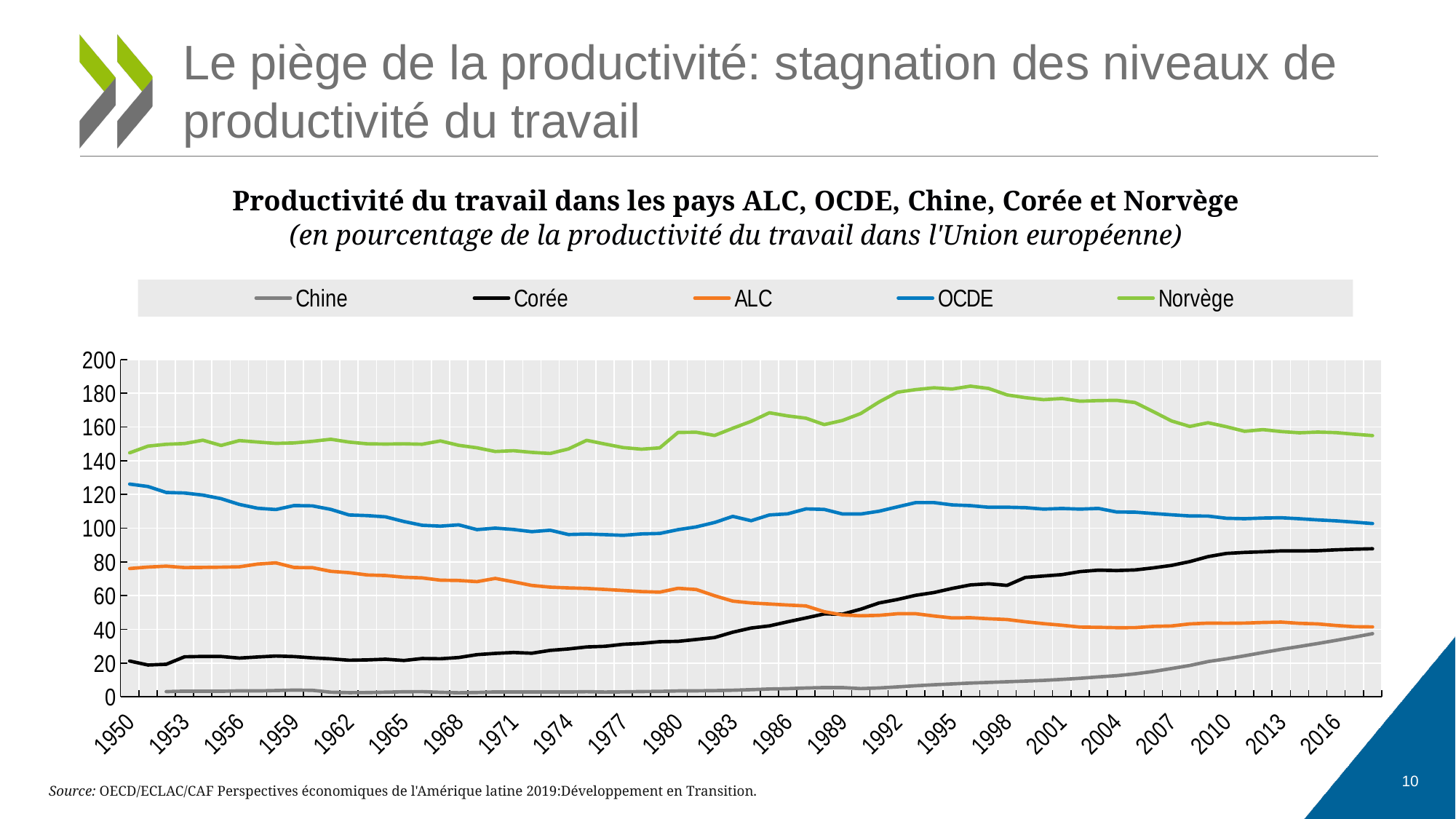
Which series has the highest values across the whole period? Norvège Does the Corée series rise or fall from 1950 to 2016? rise In 1950, which is larger: the value for ALC or the value for Corée? ALC Which series has the lowest value in 1980? Chine Does the ALC series rise or fall from 1950 to 2016? fall Is the value for OCDE in 1950 greater or less than 120? greater Is the value for ALC in 2016 greater or less than 60? less What colour is the ALC line in the chart? orange What kind of chart is shown on the slide? line chart Is the value for Corée in 2016 greater or less than 80? greater How many series does the legend list? 5